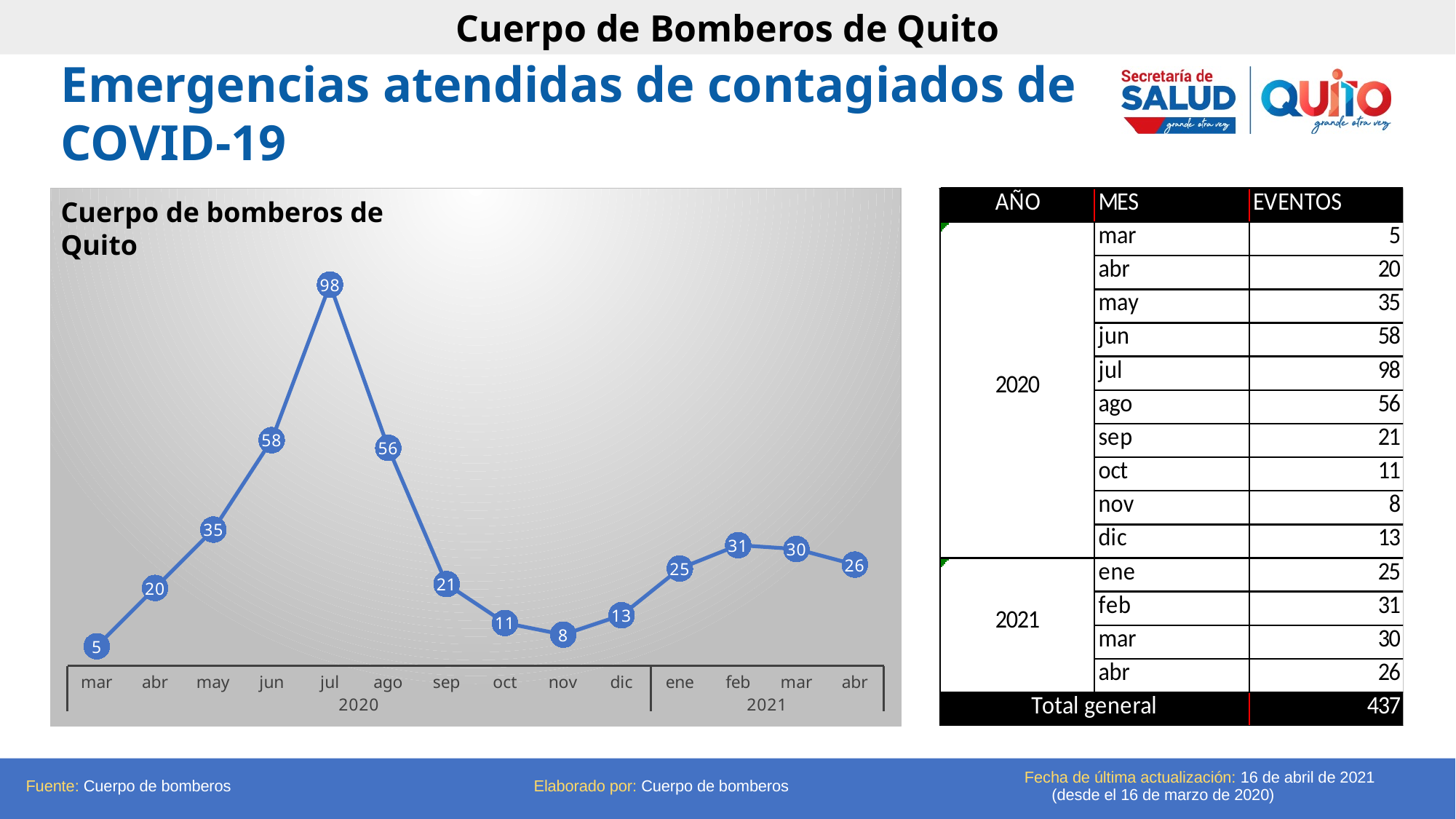
Which month has the lowest value in the chart? mar 2020 What is the difference between the values for jul 2020 and ago 2020? 42 What is the value for mar 2020 in the chart? 5 Do the values rise or fall from jul 2020 to nov 2020? fall Which is larger, the value for jun 2020 or the value for ago 2020? jun 2020 What kind of chart is shown on the slide? line chart What is the value for feb 2021 in the chart? 31 Do the values rise or fall from mar 2020 to jul 2020? rise What is the title of the chart? Cuerpo de bomberos de Quito What is the value for jul 2020 in the chart? 98 How many data points are plotted in the chart? 14 Which month has the highest value in the chart? jul 2020